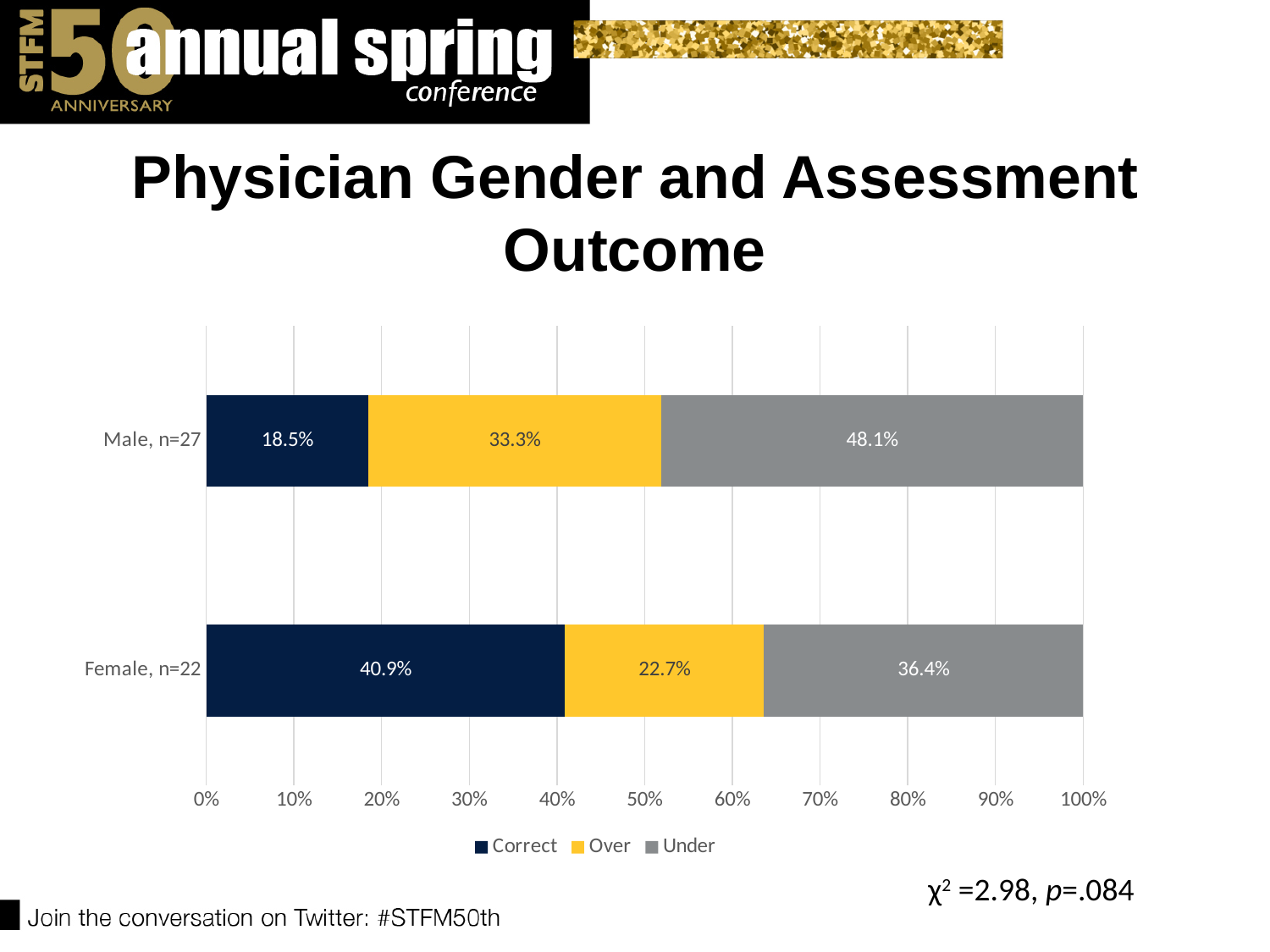
What type of chart is shown on the slide? Stacked bar chart What is the Over value for the Male, n=27 bar? 33.3% How many series does the legend list? 3 What percentage of female physicians (n=22) had an Under assessment outcome? 36.4% Which segment is the largest in the Male, n=27 bar? Under What percentage of male physicians (n=27) had a Correct assessment outcome? 18.5% How many categories (bars) are shown in the chart? 2 What is the difference between the Correct percentages for female and male physicians? 22.4% Which segment is the smallest in the Female, n=22 bar? Over What is the difference between the Under percentages for male and female physicians? 11.7% What is the title of the chart on the slide? Physician Gender and Assessment Outcome Which gender group has the higher Correct percentage? Female, n=22